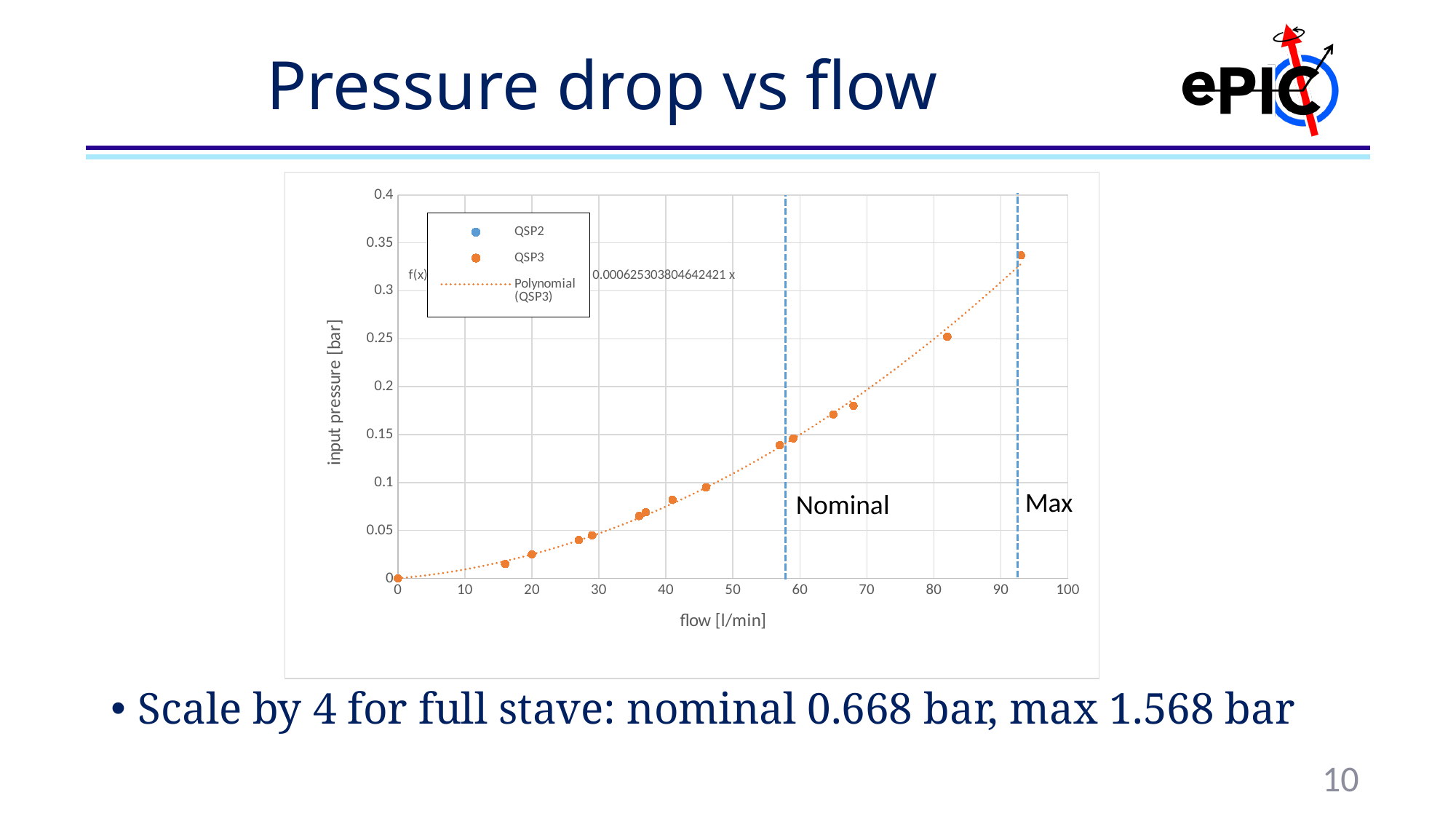
Is the input pressure at a flow of about 65 l/min greater or less than 0.15 bar? greater What is the label of the x axis of the chart? flow [l/min] Is the input pressure at a flow of about 82 l/min greater or less than 0.2 bar? greater How many entries does the chart legend list? 3 Which is larger, the input pressure at the 'Nominal' dashed line or at the 'Max' dashed line? Max Is the input pressure at a flow of about 20 l/min greater or less than 0.05 bar? less Does the input pressure rise or fall as the flow increases along the x axis? rises What kind of chart is shown on the slide? scatter chart What are the labels of the two vertical dashed lines on the chart? Nominal and Max